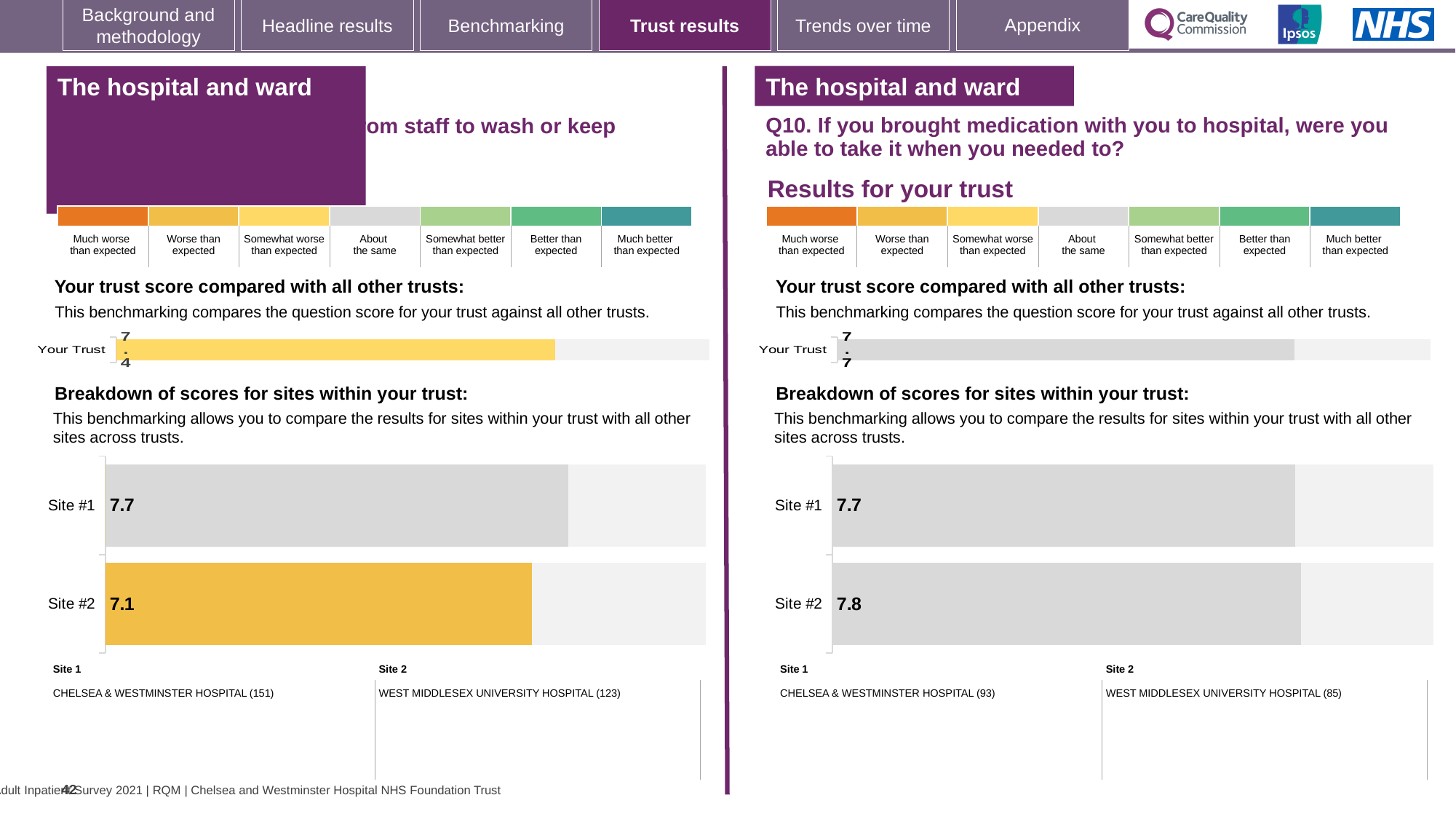
On the right-hand chart for Q10 (medication), what is the score for Site #1? 7.7 On the left-hand site breakdown chart, what colour is the bar for Site #2? Yellow On the left-hand site breakdown chart, which site has the lower score? Site #2 On the left-hand 'Your Trust' benchmarking bar, what is the trust score? 7.4 On the right-hand chart for Q10 (medication), what is the score for Site #2? 7.8 What type of chart is used for the site breakdown on the left-hand side of the slide? Bar chart On the left-hand site breakdown chart, what is the difference between the Site #1 and Site #2 scores? 0.6 On the left-hand site breakdown chart, what is the score for Site #1? 7.7 On the left-hand site breakdown chart, what is the score for Site #2? 7.1 On the right-hand 'Your Trust' benchmarking bar for Q10, what is the trust score? 7.7 How many sites are shown in the right-hand site breakdown chart for Q10? 2 On the right-hand chart for Q10, what is the difference between the Site #2 and Site #1 scores? 0.1